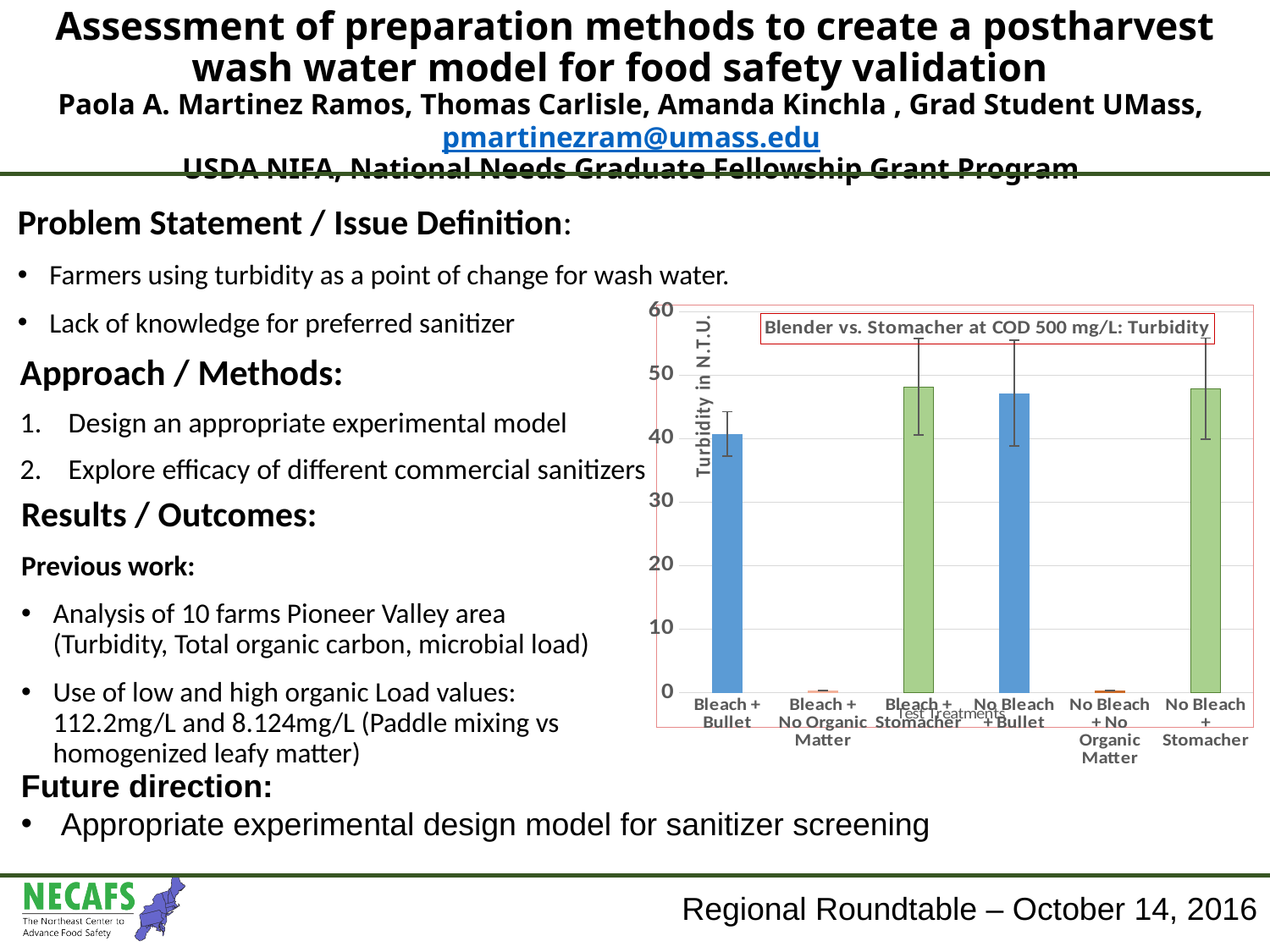
How many test treatment categories are plotted in the chart? 6 Is the value for Bleach + No Organic Matter greater or less than 10? less Which has the larger value, Bleach + Bullet or No Bleach + Bullet? No Bleach + Bullet What kind of chart is shown on the slide? bar chart Is the value for Bleach + Stomacher greater or less than 40? greater Is the value for Bleach + Bullet greater or less than 50? less What is the title of the chart? Blender vs. Stomacher at COD 500 mg/L: Turbidity Which has the larger value, Bleach + Bullet or Bleach + Stomacher? Bleach + Stomacher What is the label of the vertical axis of the chart? Turbidity in N.T.U.